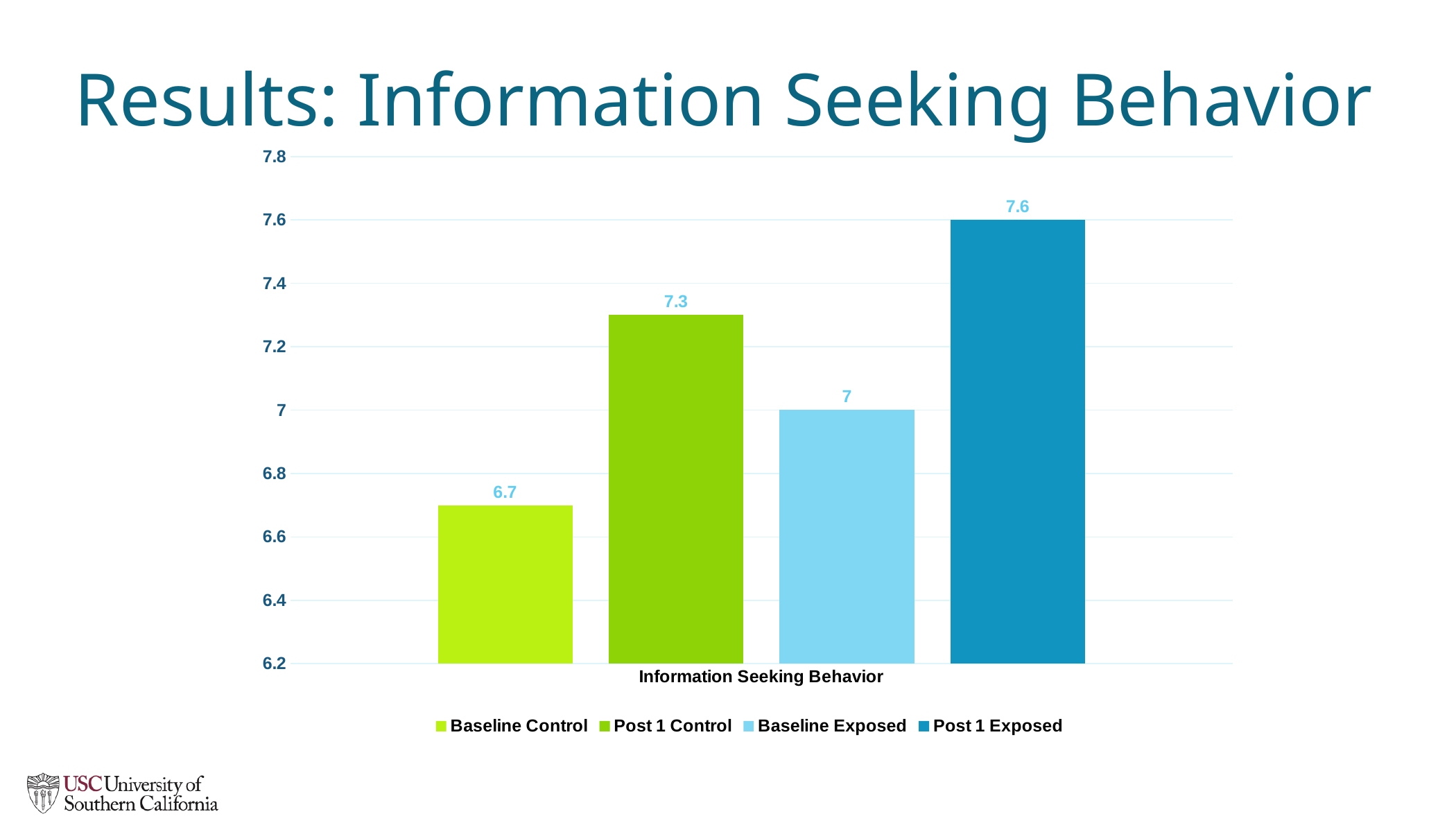
What is the value for Baseline Exposed? 7 What is the label on the x axis of the chart? Information Seeking Behavior What is the value for Post 1 Control? 7.3 Which series has the lowest value? Baseline Control What is the difference between the Post 1 Control and Baseline Control values? 0.6 How many series does the legend list? 4 What is the value for Post 1 Exposed? 7.6 Which series has the highest value? Post 1 Exposed What kind of chart is shown on the slide? Bar chart What is the value for Baseline Control? 6.7 What is the difference between the Post 1 Exposed and Baseline Exposed values? 0.6 Which is larger, the value for Post 1 Control or the value for Baseline Exposed? Post 1 Control